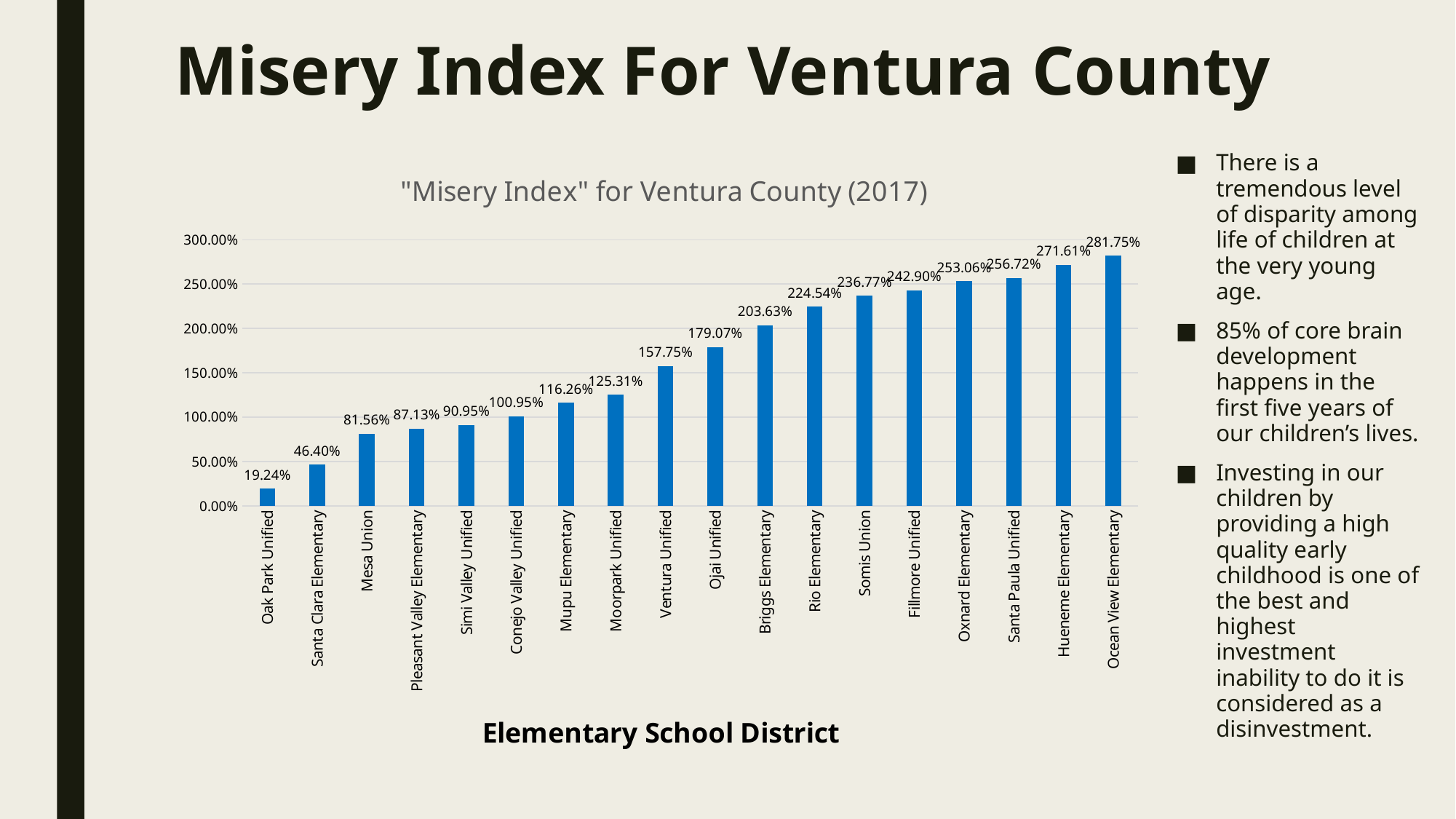
What is the difference between the Misery Index for Rio Elementary and Briggs Elementary? 20.91% Which elementary school district has the highest Misery Index? Ocean View Elementary What is the Misery Index value for Ventura Unified? 157.75% Which has a higher Misery Index, Mupu Elementary or Ojai Unified? Ojai Unified What is the Misery Index value for Oak Park Unified? 19.24% What is the Misery Index value for Fillmore Unified? 242.90% Which elementary school district has the lowest Misery Index? Oak Park Unified Do the Misery Index values rise or fall from left to right along the x axis? Rise What is the difference between the Misery Index for Ocean View Elementary and Oak Park Unified? 262.51% Is the Misery Index for Conejo Valley Unified greater or less than 150.00%? less How many elementary school districts are shown in the chart? 18 What kind of chart is used to show the Misery Index? Bar chart